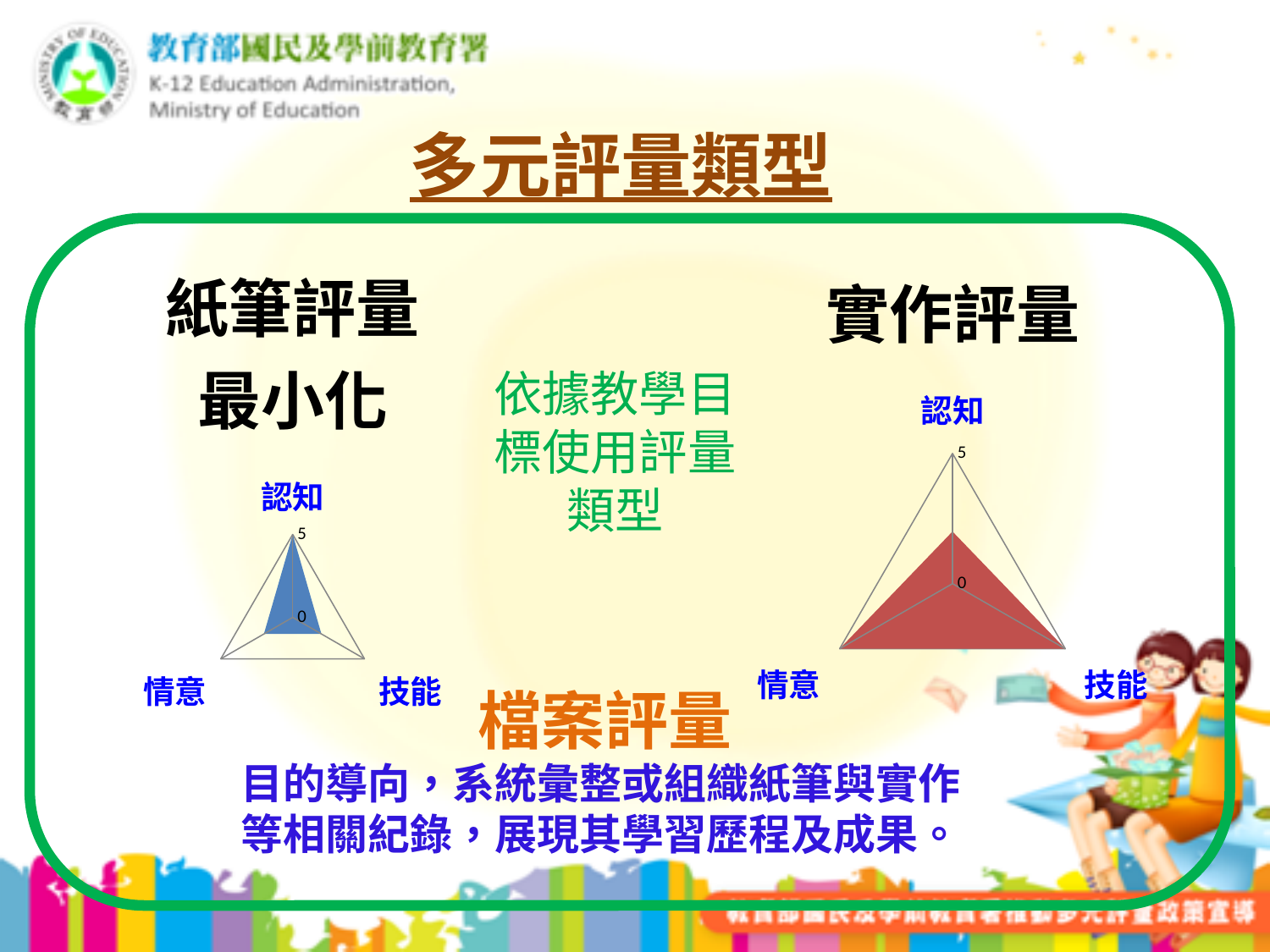
In the right radar chart (實作評量), what is the value for 情意? 5 In the right radar chart (實作評量), how many axes (categories) are there? 3 In the left radar chart (紙筆評量), which is larger, the value for 認知 or the value for 情意? 認知 In the right radar chart (實作評量), which category has the lowest value? 認知 In the left radar chart (紙筆評量), is the value for 技能 greater or less than 5? less In the left radar chart (紙筆評量), which category has the highest value? 認知 In the left radar chart (紙筆評量), what is the value for 認知? 5 In the left radar chart (紙筆評量), how many axes (categories) are there? 3 In the right radar chart (實作評量), is the value for 認知 greater or less than 5? less What kind of chart is shown under the heading 紙筆評量 on the left of the slide? radar chart In the right radar chart (實作評量), what is the value for 技能? 5 What kind of chart is shown under the heading 實作評量 on the right of the slide? radar chart